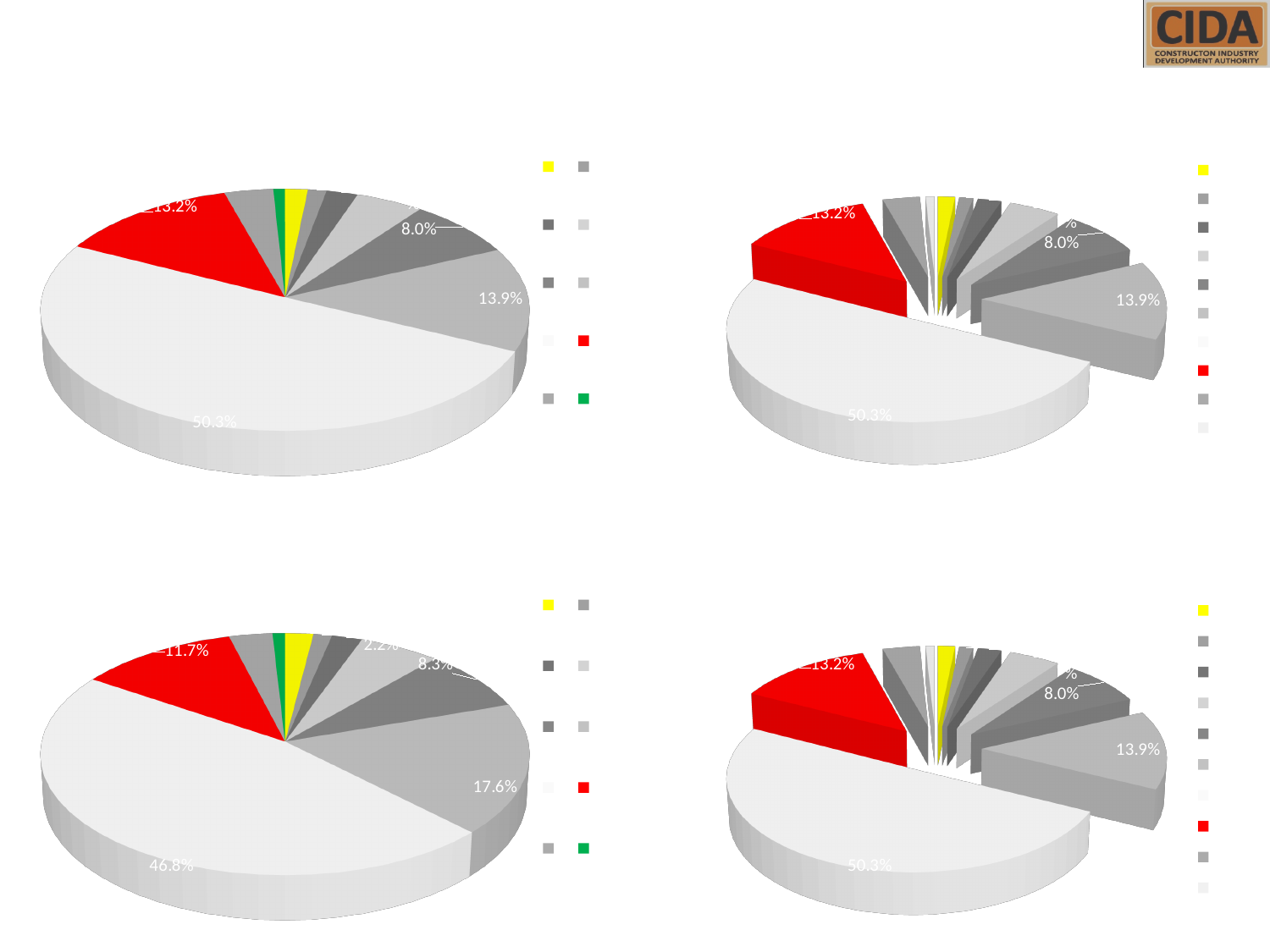
Which is larger: the 17.6% slice in the bottom-left pie chart or the 13.9% slice in the top-left pie chart? 17.6% slice in the bottom-left pie chart In the top-left pie chart, which labelled slice is larger: the one labelled 13.9% or the one labelled 8.0%? 13.9% How many pie charts are shown on the slide? 4 In the top-left pie chart, what is the difference between the slice labelled 50.3% and the slice labelled 13.9%? 36.4% In the bottom-left pie chart, what percentage is labelled on the red slice? 11.7% In the bottom-left pie chart, what is the difference between the largest slice (46.8%) and the slice labelled 17.6%? 29.2% In the top-left pie chart, what percentage is labelled on the largest slice? 50.3% In the bottom-left pie chart, what is the difference between the slices labelled 17.6% and 8.3%? 9.3% What kind of chart is shown in the top-left position of the slide? pie chart In the top-left pie chart, what percentage is labelled on the red slice? 13.2% What colour is the largest slice in the top-right pie chart? light grey In the bottom-left pie chart, what percentage is labelled on the largest slice? 46.8%